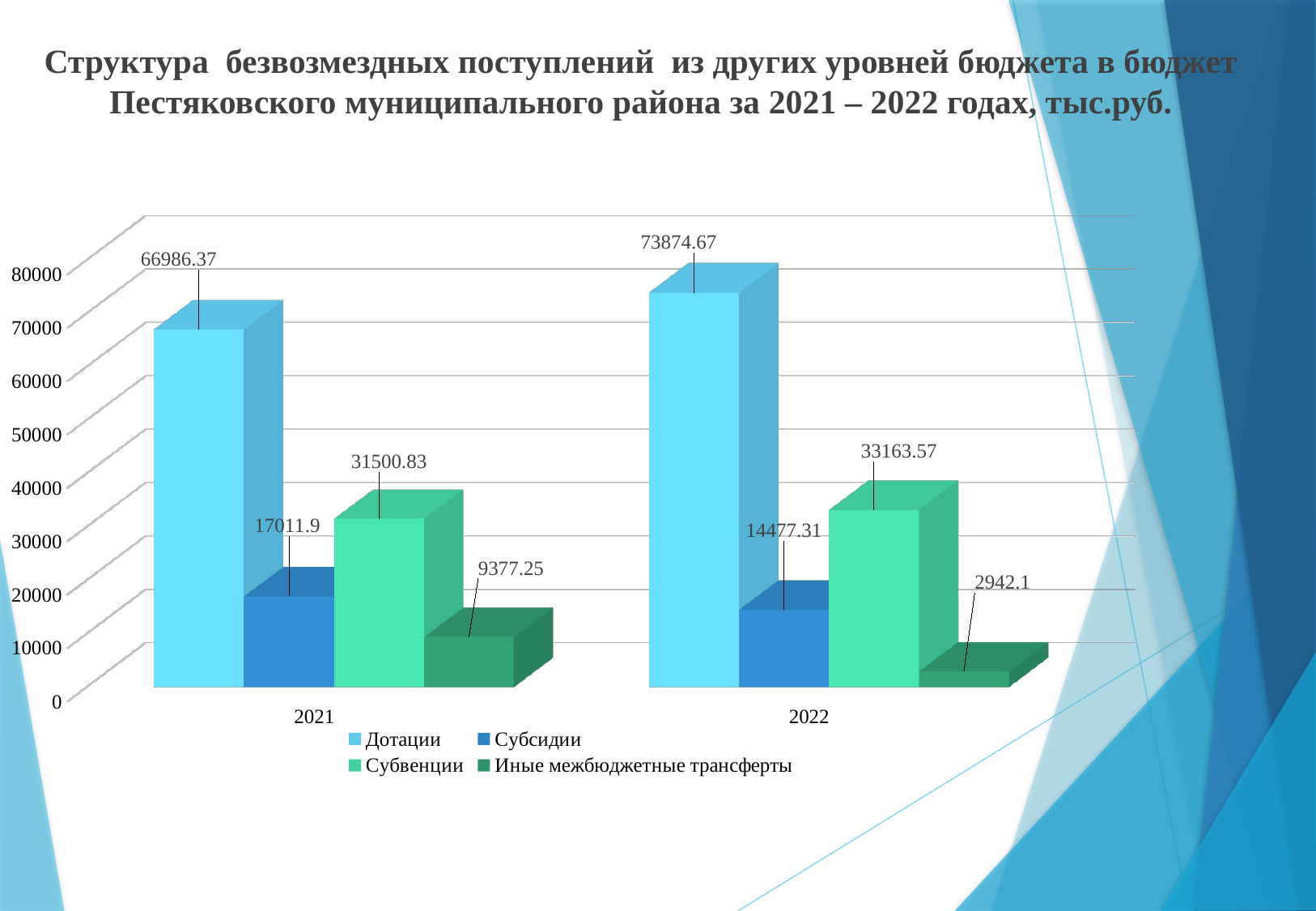
What is the value for Субвенции in 2022? 33163.57 What is the value for Дотации in 2021? 66986.37 Which series has the lowest value in 2021? Иные межбюджетные трансферты Do the values for Субвенции rise or fall from 2021 to 2022? Rise By how much did Дотации increase from 2021 to 2022? 6888.3 Which is larger: Субсидии in 2021 or Субсидии in 2022? Субсидии in 2021 What is the difference between Иные межбюджетные трансферты in 2021 and in 2022? 6435.15 Which series has the highest value in 2022? Дотации What kind of chart is shown on the slide? Bar chart How many series does the legend list? 4 What is the value for Иные межбюджетные трансферты in 2022? 2942.1 What is the value for Субсидии in 2021? 17011.9